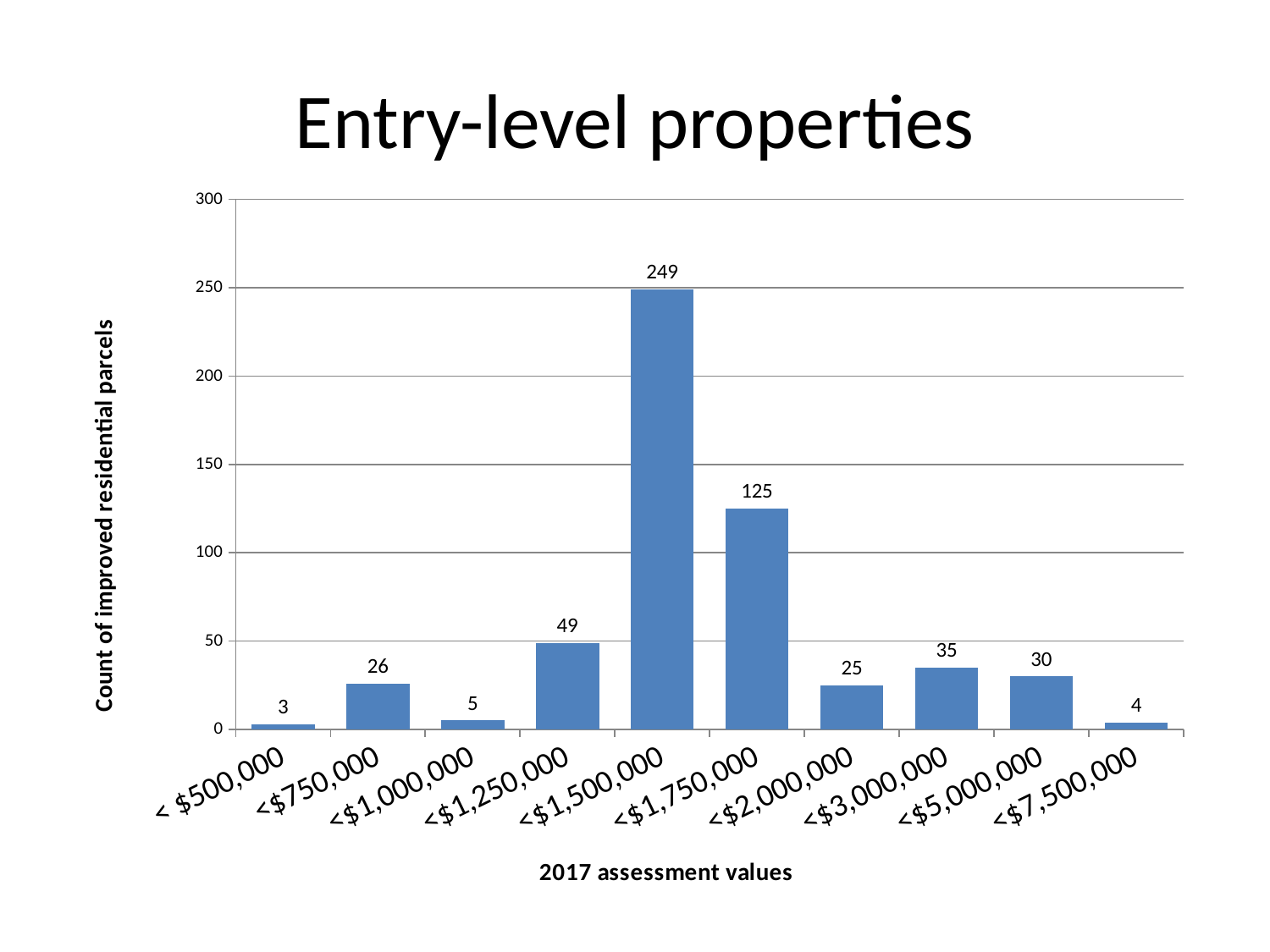
What is the title of the chart's x axis? 2017 assessment values What is the count of improved residential parcels for the <$1,500,000 category? 249 What is the count of improved residential parcels for the <$1,750,000 category? 125 What is the difference between the counts for <$1,500,000 and <$1,750,000? 124 What is the title of the chart's y axis? Count of improved residential parcels Which assessment value category has the highest count of improved residential parcels? <$1,500,000 What is the difference between the counts for <$1,250,000 and <$750,000? 23 Which has a higher count, <$3,000,000 or <$5,000,000? <$3,000,000 What is the count of improved residential parcels for the < $500,000 category? 3 Which assessment value category has the lowest count of improved residential parcels? < $500,000 What kind of chart is shown on the slide? Bar chart How many assessment value categories are shown on the x axis? 10